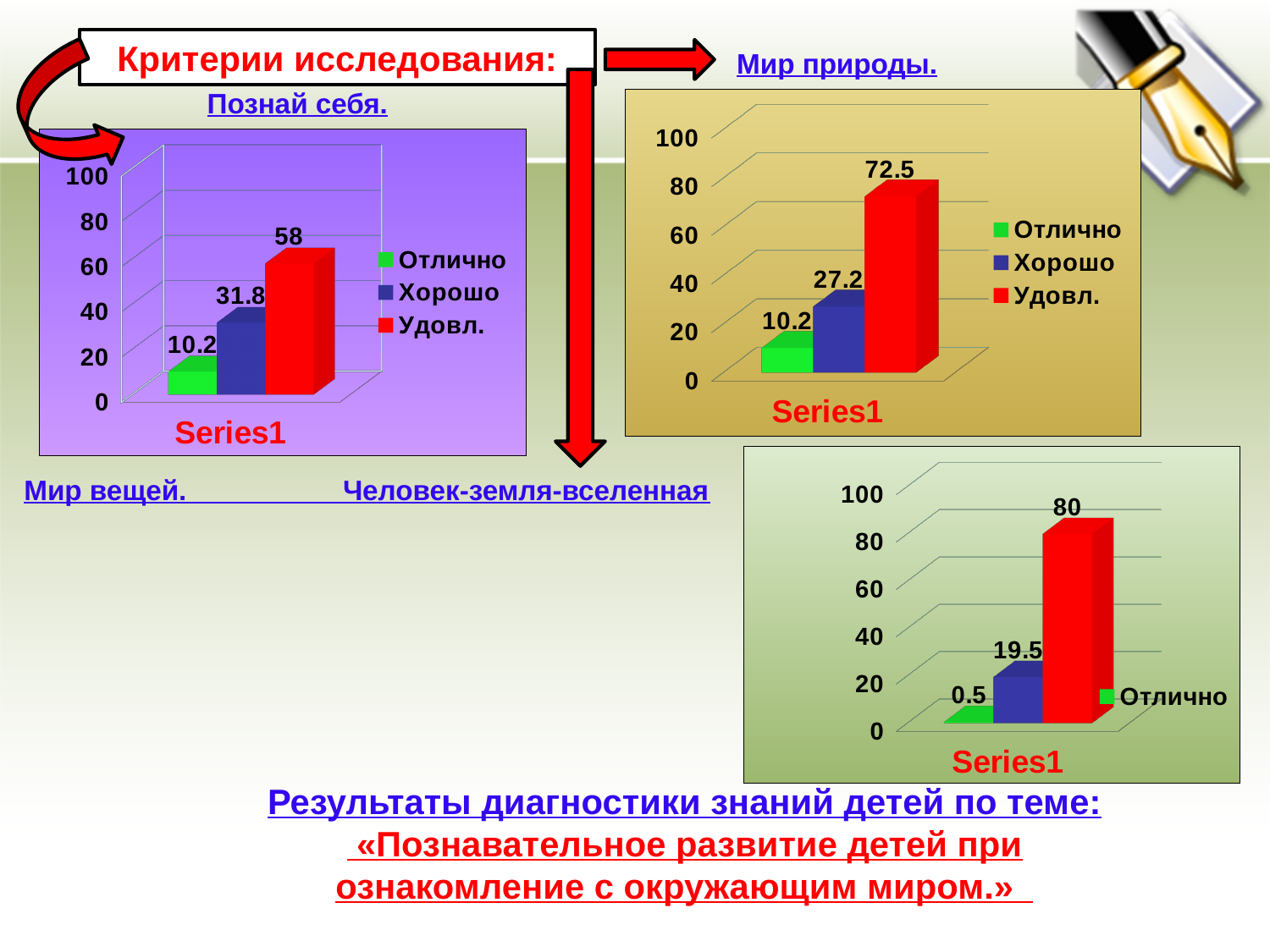
In the 'Мир природы' chart, which category has the highest value? Удовл. In the bottom-right chart, what is the value of the tallest (red) bar? 80 In the 'Познай себя' chart, what is the difference between the Удовл. and Хорошо values? 26.2 In the 'Познай себя' chart, what is the value for Удовл.? 58 In the 'Познай себя' chart, what is the value for Хорошо? 31.8 In the bottom-right chart, what is the value of the smallest (green) bar? 0.5 What type of chart is the 'Познай себя' chart? Bar chart In the 'Мир природы' chart, what is the difference between the Удовл. and Отлично values? 62.3 How many series does the legend of the 'Мир природы' chart list? 3 In the 'Мир природы' chart, what is the value for Хорошо? 27.2 In the 'Познай себя' chart, which category has the lowest value? Отлично In the 'Мир природы' chart, what is the value for Удовл.? 72.5